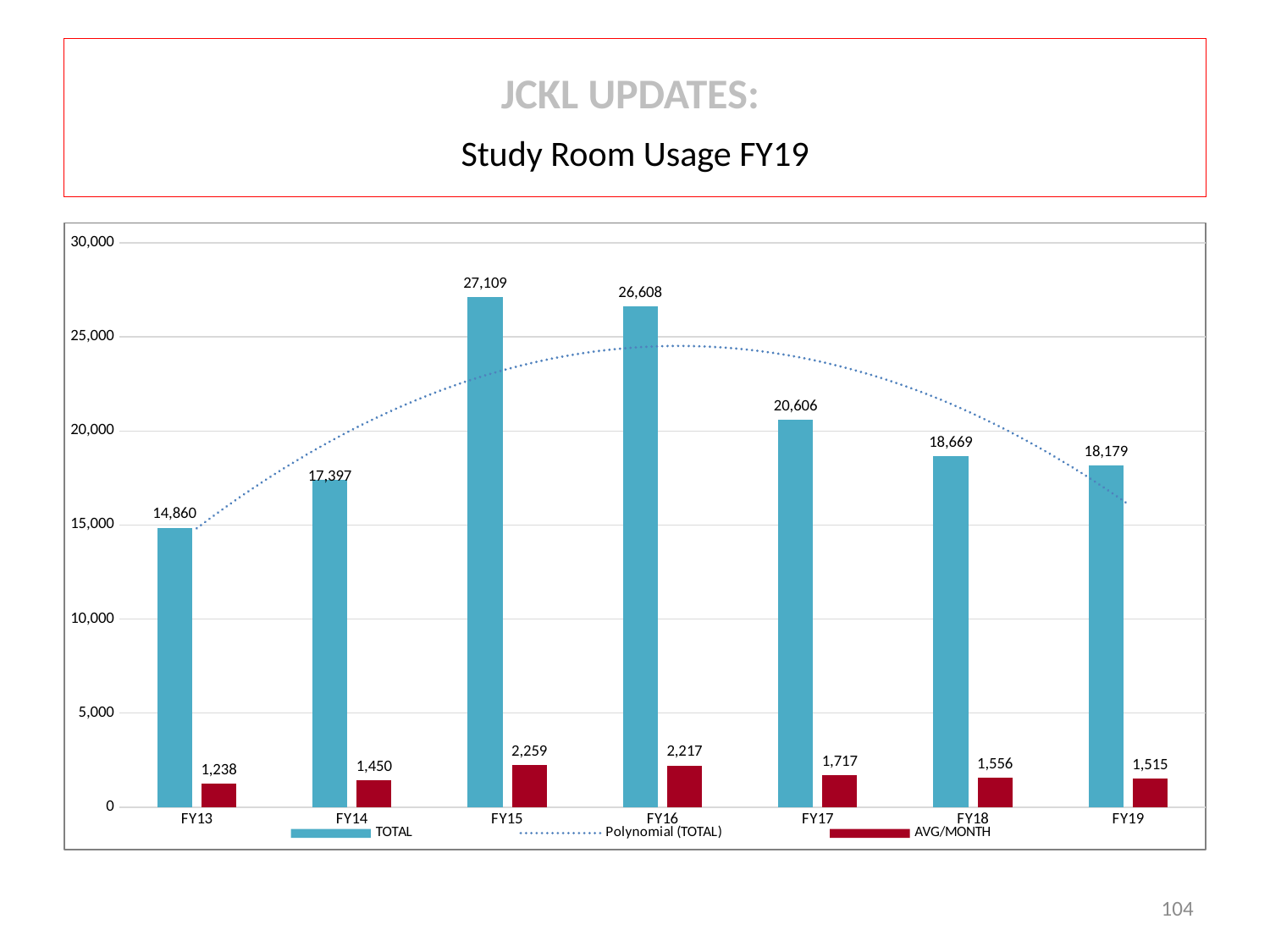
What is the difference between the TOTAL for FY19 and the TOTAL for FY13? 3,319 What is the difference between the TOTAL for FY15 and the TOTAL for FY16? 501 Which is larger, the TOTAL for FY17 or the TOTAL for FY18? FY17 Which fiscal year has the highest TOTAL? FY15 Which fiscal year has the lowest AVG/MONTH? FY13 What is the TOTAL value for FY15? 27,109 How many entries does the legend list? 3 What is the AVG/MONTH value for FY19? 1,515 What is the TOTAL value for FY13? 14,860 Is the TOTAL for FY14 greater or less than 20,000? less How many fiscal years are shown on the x axis? 7 What kind of chart is shown on the slide? bar chart